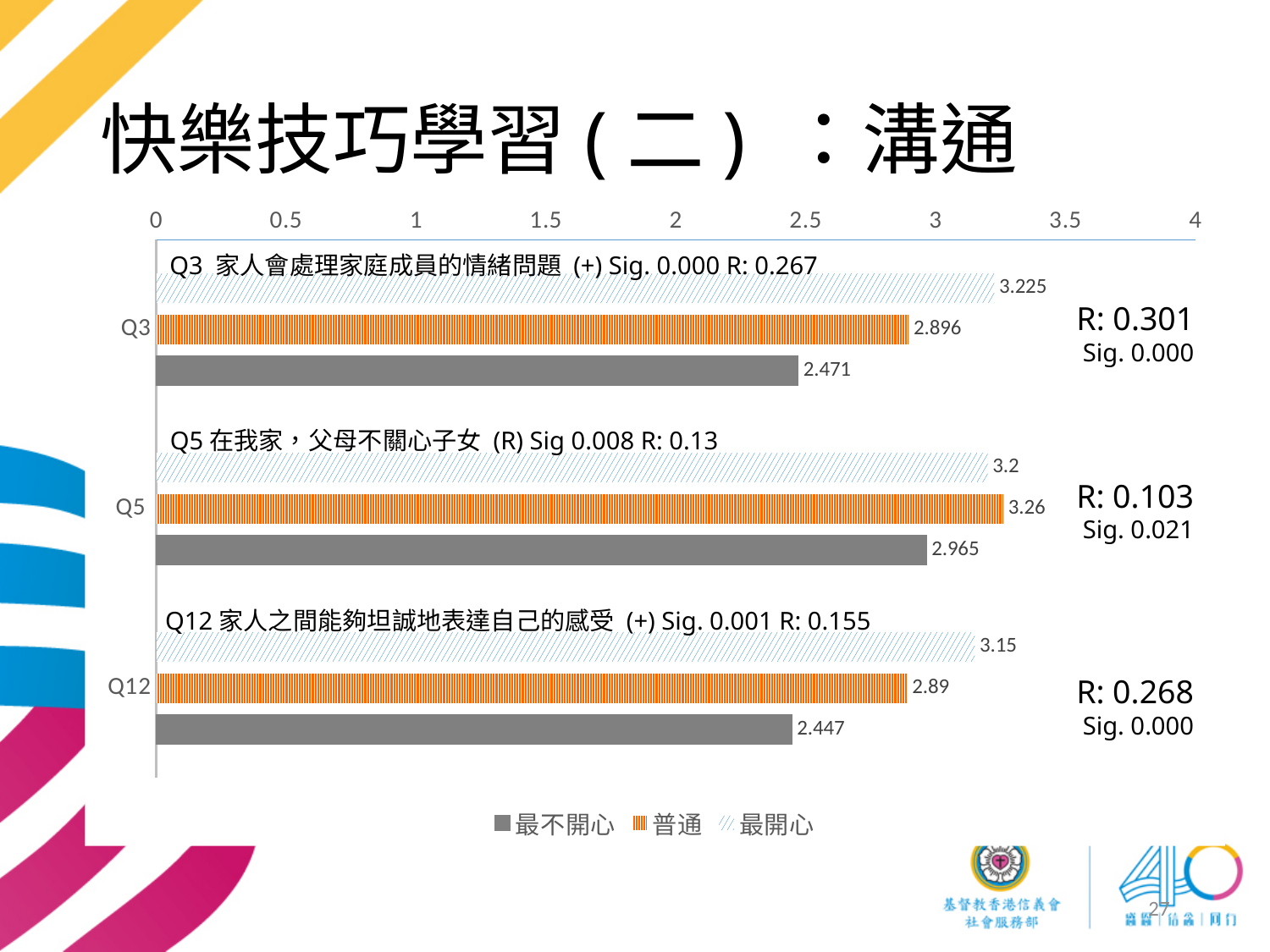
Is the value of 最不開心 for Q3 greater or less than 2.5? less How many categories are shown on the chart? 3 How many series does the legend list? 3 Which category has the highest value for 最不開心? Q5 What is the value of 最開心 for Q3? 3.225 What is the difference between the 最開心 and 最不開心 values for Q3? 0.754 What is the value of 普通 for Q5? 3.26 For Q12, which is larger: the 普通 value or the 最不開心 value? 普通 What kind of chart is shown on the slide? bar chart Which category has the lowest value for 最開心? Q12 What is the value of 最不開心 for Q12? 2.447 What is the value of 最不開心 for Q5? 2.965